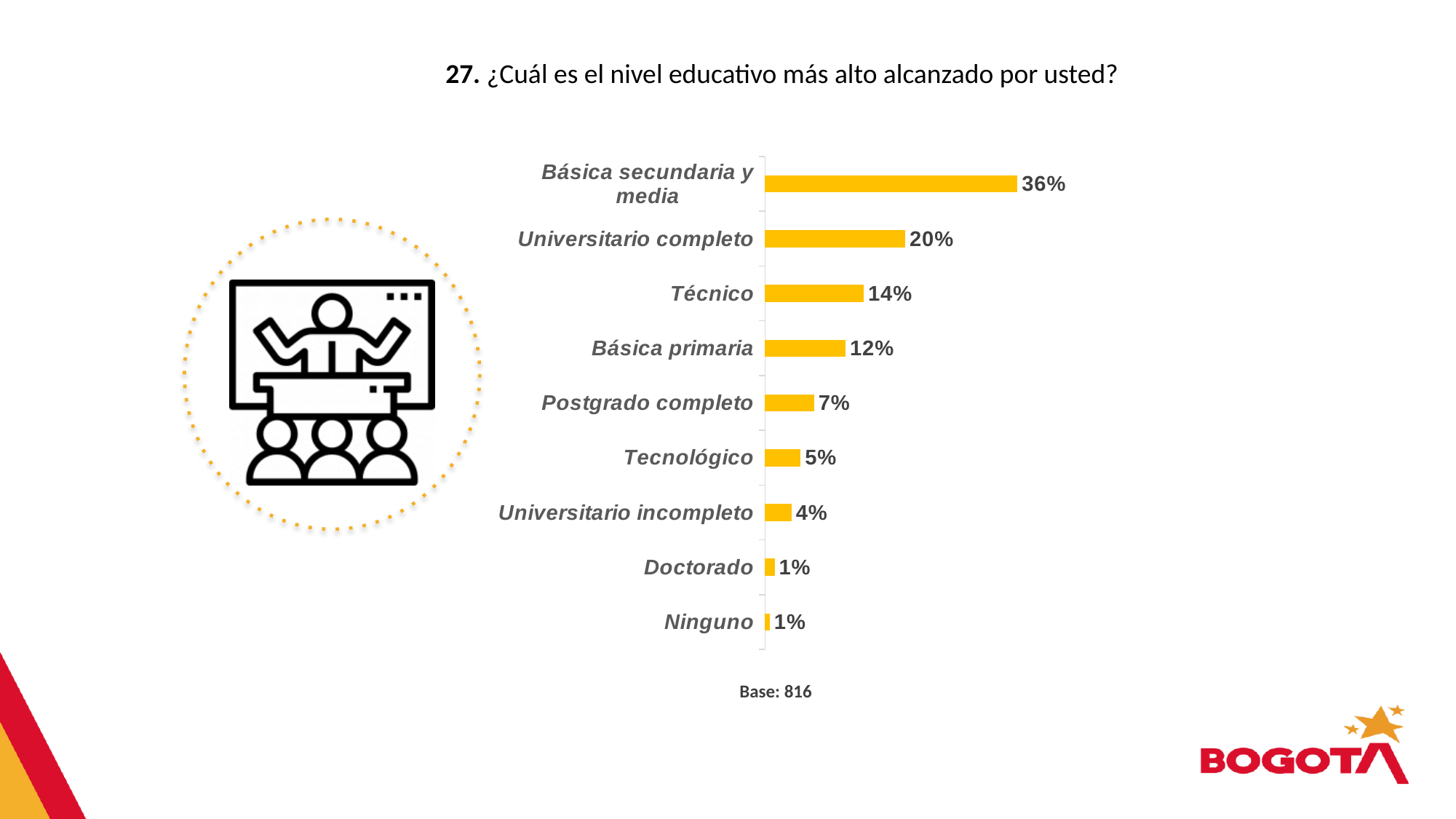
What is the difference between 'Técnico' and 'Básica primaria'? 2% What type of chart is shown on the slide? Bar chart What percentage is shown for 'Técnico'? 14% What percentage of respondents reported 'Básica secundaria y media' as their highest education level? 36% What is the value shown for 'Universitario completo'? 20% What is the value for 'Postgrado completo'? 7% What colour are the bars in the chart? Yellow How many education level categories are shown in the chart? 9 What is the difference between 'Básica secundaria y media' and 'Universitario completo'? 16% Which is larger, 'Tecnológico' or 'Universitario incompleto'? Tecnológico Which education level has the highest percentage? Básica secundaria y media What is the base (number of respondents) shown below the chart? 816